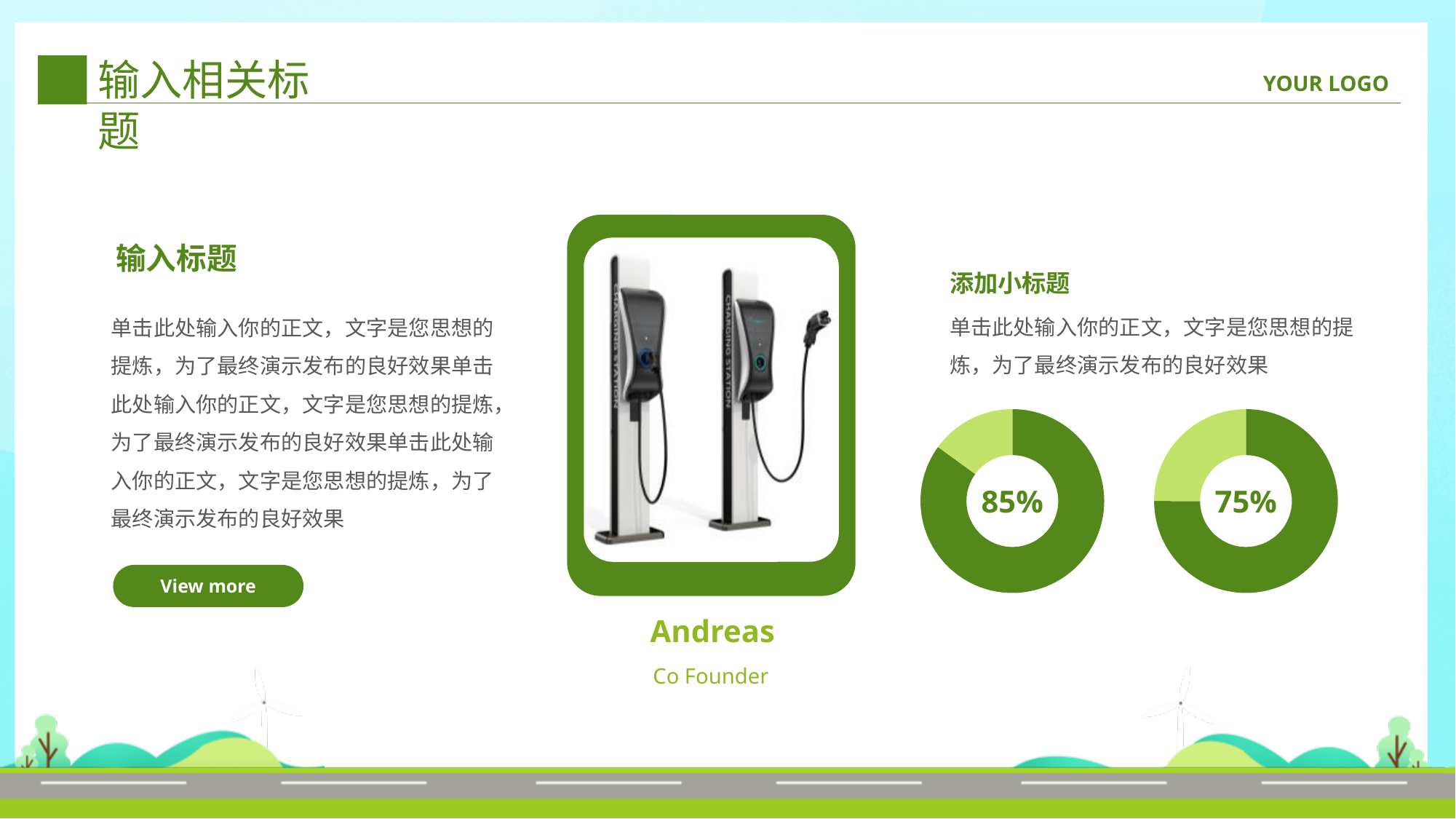
What kind of chart is shown on the right of the two charts on the right side of the slide? Donut chart What colour is the largest segment of the left donut chart? Dark green Which donut chart shows the larger percentage, the left one or the right one? The left one What is the difference between the percentage in the left donut chart and the percentage in the right donut chart? 10% What kind of chart is shown on the left of the two charts on the right side of the slide? Donut chart What percentage is printed in the centre of the right donut chart? 75% What is the heading printed above the two donut charts? 添加小标题 How many donut charts are shown on the slide? 2 What percentage is printed in the centre of the left donut chart? 85%